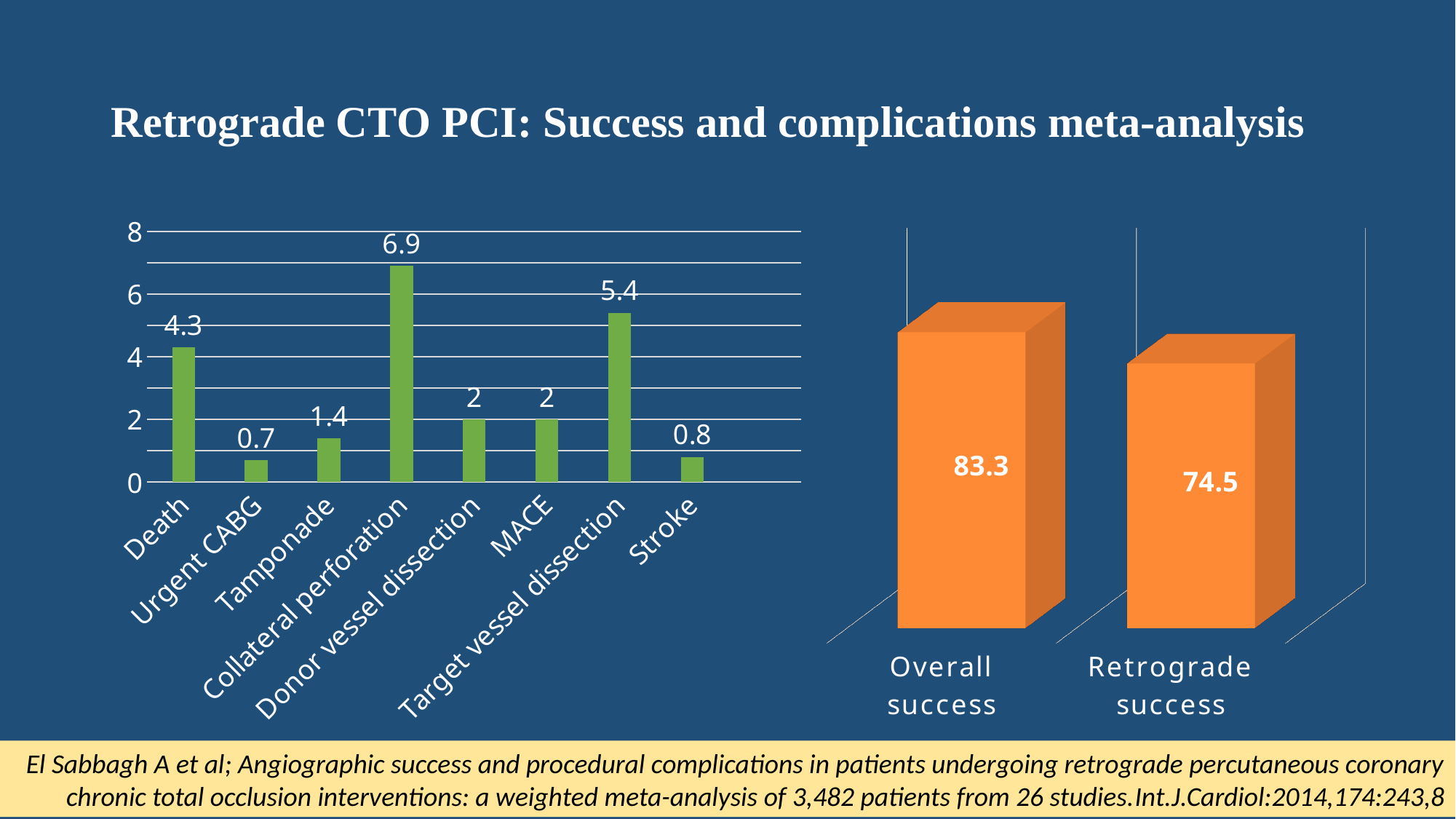
How many categories are shown in the left chart? 8 What colour are the bars in the right chart? Orange In the left chart, what is the difference between the values for Target vessel dissection and Death? 1.1 In the right chart, what is the value for Overall success? 83.3 In the left chart, which category has the lowest value? Urgent CABG In the right chart, what is the difference between Overall success and Retrograde success? 8.8 In the left chart, which category has the highest value? Collateral perforation In the left chart, which is larger, the value for Tamponade or the value for Stroke? Tamponade In the left chart, what is the value for Urgent CABG? 0.7 In the left chart, what is the value for Collateral perforation? 6.9 What kind of chart is the left chart? Bar chart In the right chart, what is the value for Retrograde success? 74.5